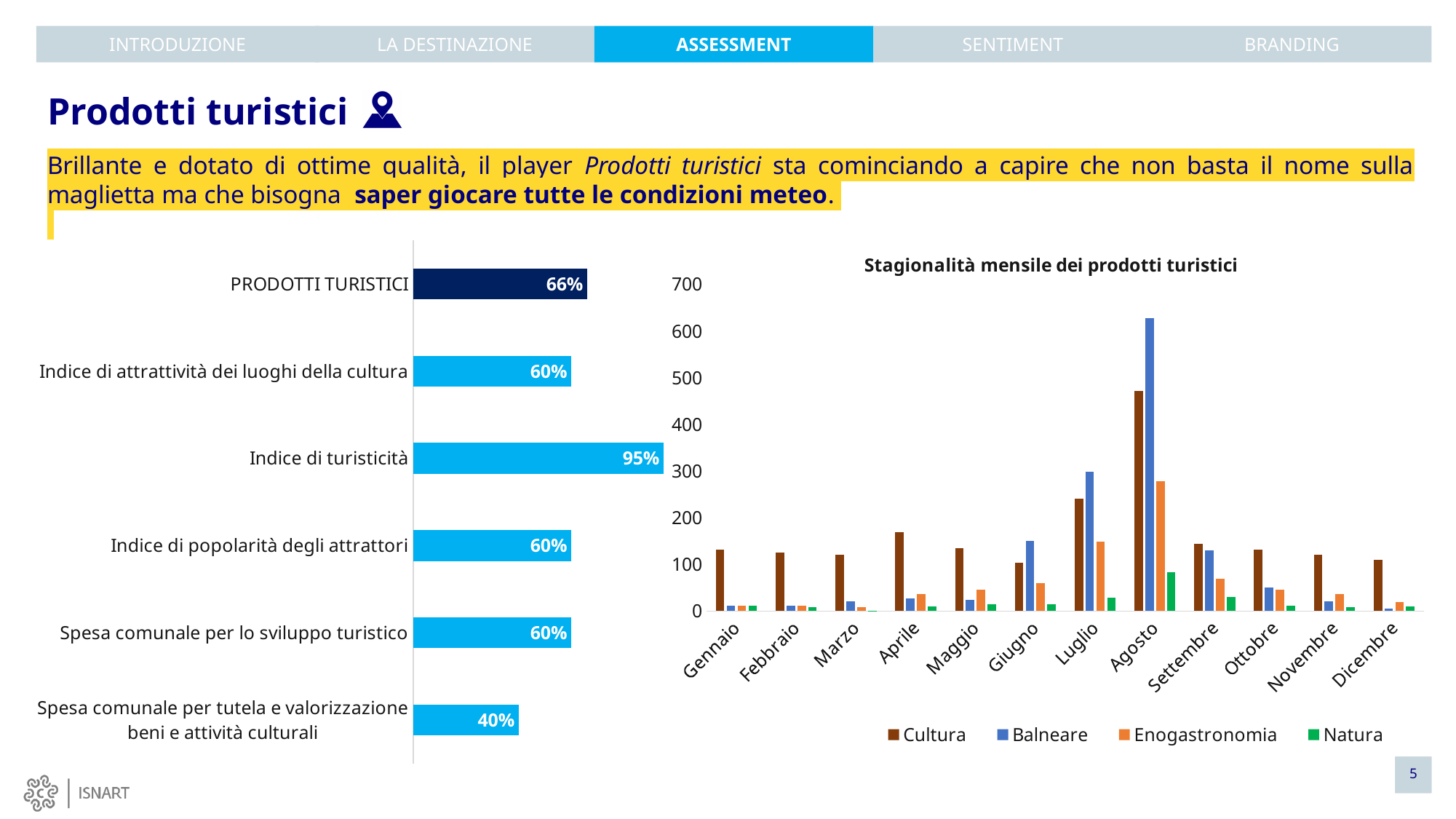
On the left bar chart, what is the value for Indice di turisticità? 95% On the left bar chart, what is the value for PRODOTTI TURISTICI? 66% What kind of chart is 'Stagionalità mensile dei prodotti turistici'? bar chart In the chart 'Stagionalità mensile dei prodotti turistici', how many series does the legend list? 4 On the left bar chart, how many categories are shown? 6 On the left bar chart, which category has the lowest value? Spesa comunale per tutela e valorizzazione beni e attività culturali In the chart 'Stagionalità mensile dei prodotti turistici', is the value for Balneare in Agosto greater or less than 600? greater On the left bar chart, which category has the highest value? Indice di turisticità In the chart 'Stagionalità mensile dei prodotti turistici', in which month does Balneare reach its highest value? Agosto On the left bar chart, what is the difference between Indice di turisticità and PRODOTTI TURISTICI? 29% In the chart 'Stagionalità mensile dei prodotti turistici', is the value for Natura in Agosto greater or less than 100? less On the left bar chart, what is the value for Spesa comunale per tutela e valorizzazione beni e attività culturali? 40%